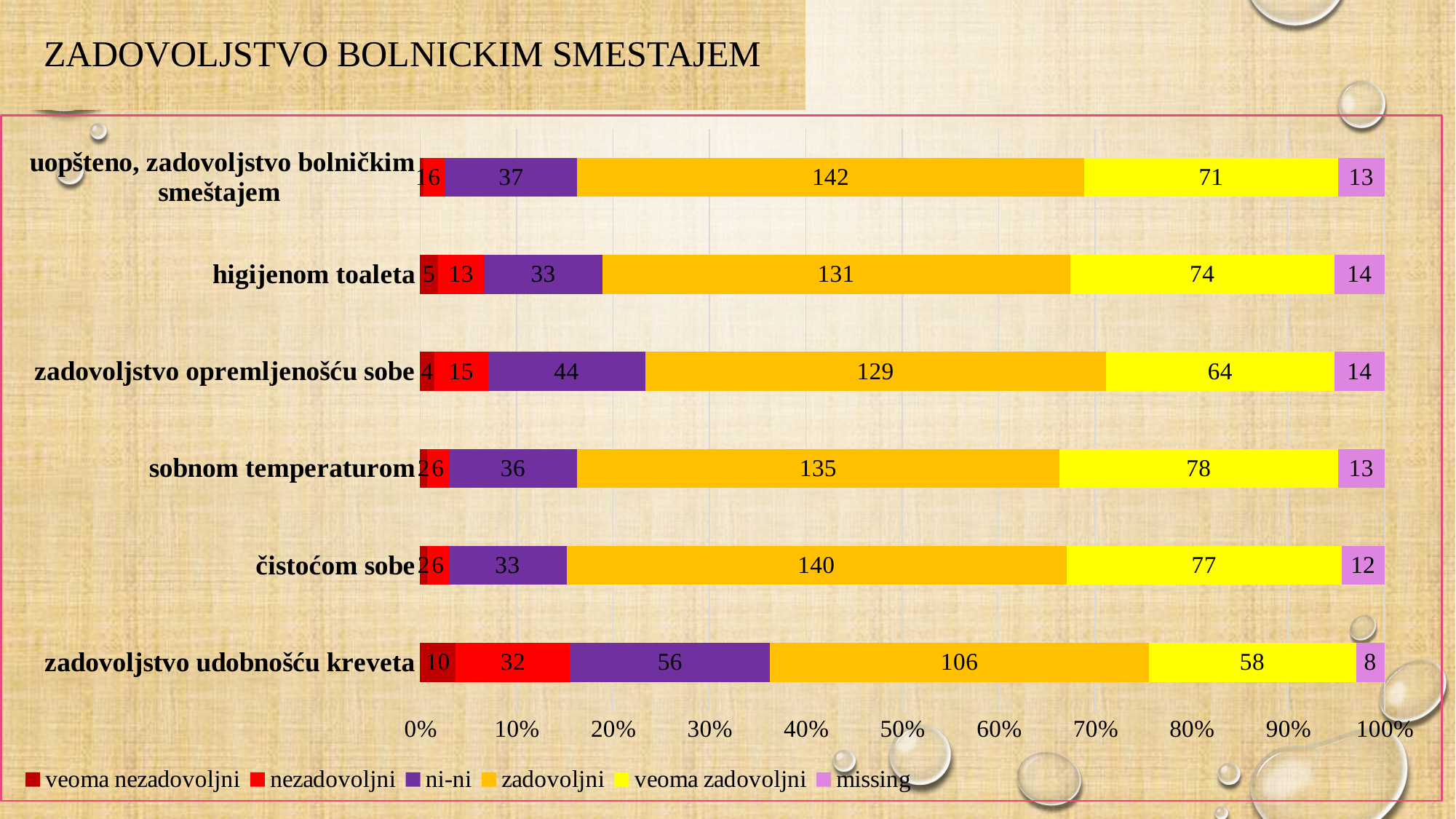
Which category has the lowest 'zadovoljni' value? zadovoljstvo udobnošću kreveta What is the value of 'nezadovoljni' for 'zadovoljstvo udobnošću kreveta'? 32 How many categories are plotted on the chart? 6 What is the total of all segments in the 'zadovoljstvo udobnošću kreveta' bar? 270 What is the difference between the 'ni-ni' value for 'zadovoljstvo udobnošću kreveta' and for 'higijenom toaleta'? 23 What is the value of 'veoma zadovoljni' for 'sobnom temperaturom'? 78 How many series does the legend list? 6 What colour represents 'zadovoljni' in the legend? orange Which has the larger 'missing' value: 'higijenom toaleta' or 'čistoćom sobe'? higijenom toaleta What kind of chart is shown on the slide? stacked bar chart Which category has the highest 'zadovoljni' value? uopšteno, zadovoljstvo bolničkim smeštajem What is the value of 'zadovoljni' for 'higijenom toaleta'? 131